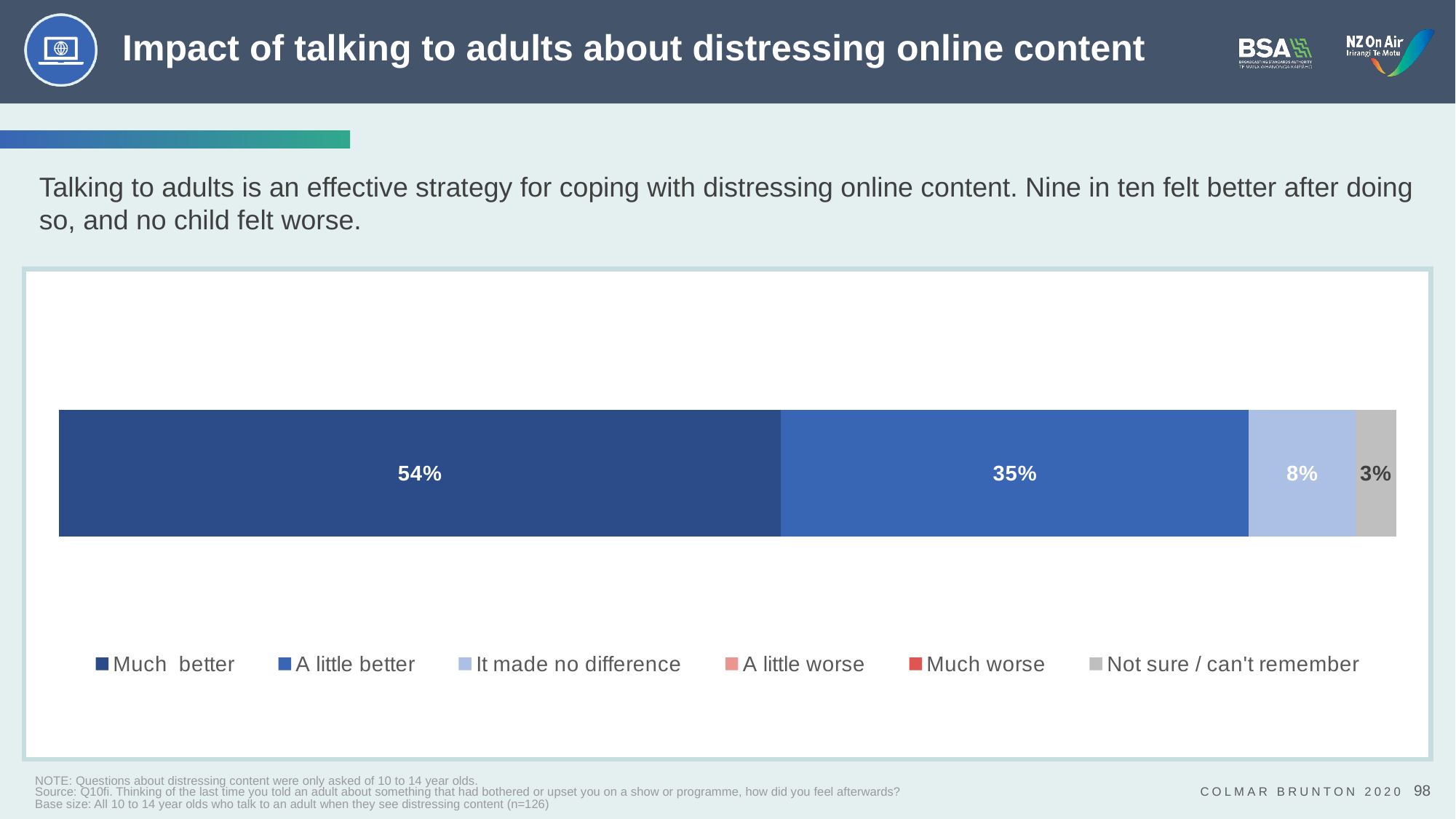
What kind of chart is shown on the slide? Stacked bar chart What percentage of children said they felt "A little better"? 35% What percentage of children answered "Not sure / can't remember"? 3% What is the combined percentage of children who felt "Much better" or "A little better"? 89% Which response has the largest share of the bar? Much better Which legend entries have no visible segment in the bar? A little worse and Much worse What percentage of children said "It made no difference"? 8% Which is larger, the share for "It made no difference" or the share for "Not sure / can't remember"? It made no difference What percentage of children said they felt "Much better" after talking to an adult? 54% How many series does the legend list? 6 What is the difference in percentage points between "Much better" and "A little better"? 19 What colour is the segment for "Not sure / can't remember"? Grey